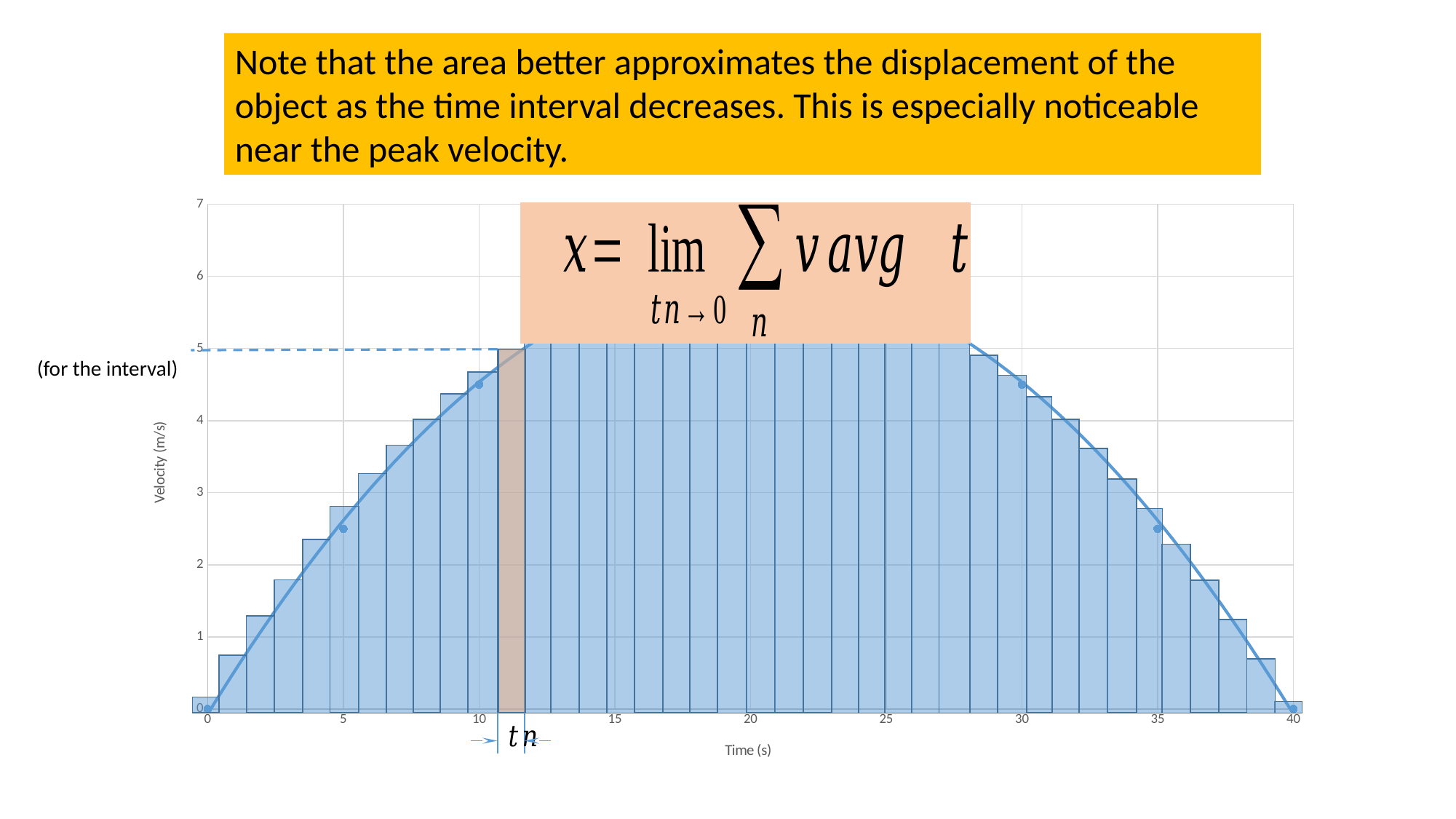
What is the title of the vertical axis of the chart? Velocity (m/s) Which is larger, the velocity at time 20 s or the velocity at time 5 s? time 20 s What is the title of the horizontal axis of the chart? Time (s) Which is larger, the velocity at time 10 s or the velocity at time 35 s? time 10 s Do the velocity values rise or fall along the x axis between time 0 s and time 10 s? rise Is the velocity value at time 10 s greater or less than 4? greater Do the velocity values rise or fall along the x axis between time 30 s and time 40 s? fall Is the velocity value at time 5 s greater or less than 3? less What is the velocity value plotted at time 0 s? 0 What kind of chart is shown on the slide? bar chart with a line overlay Is the velocity value at time 35 s greater or less than 3? less